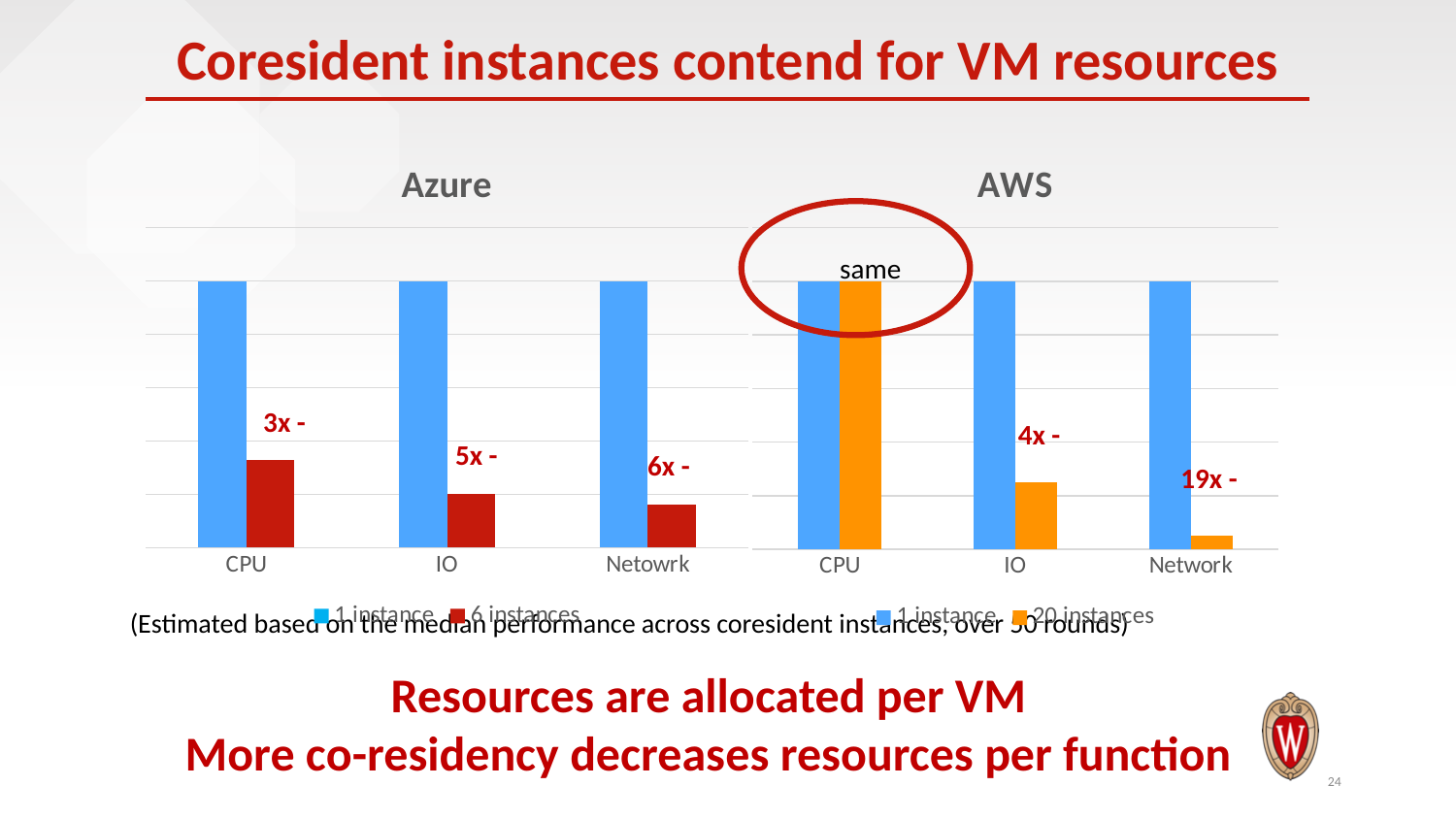
In the AWS chart, which category has the lowest 20 instances bar? Network In the AWS chart, what label is written above the CPU bars? same In the AWS chart, which is larger for IO: the 1 instance bar or the 20 instances bar? 1 instance In the Azure chart, which category has the lowest 6 instances bar? Netowrk How many series does the legend of the Azure chart list? 2 What kind of chart is the Azure chart? bar chart How many categories are shown on the x axis of the AWS chart? 3 In the Azure chart, which is larger for CPU: the 1 instance bar or the 6 instances bar? 1 instance In the AWS chart, do the 20 instances bars rise or fall from CPU to Network? fall In the AWS chart, which category has the highest 20 instances bar? CPU What are the two legend entries of the AWS chart? 1 instance, 20 instances In the Azure chart, do the 6 instances bars rise or fall from CPU to Netowrk? fall